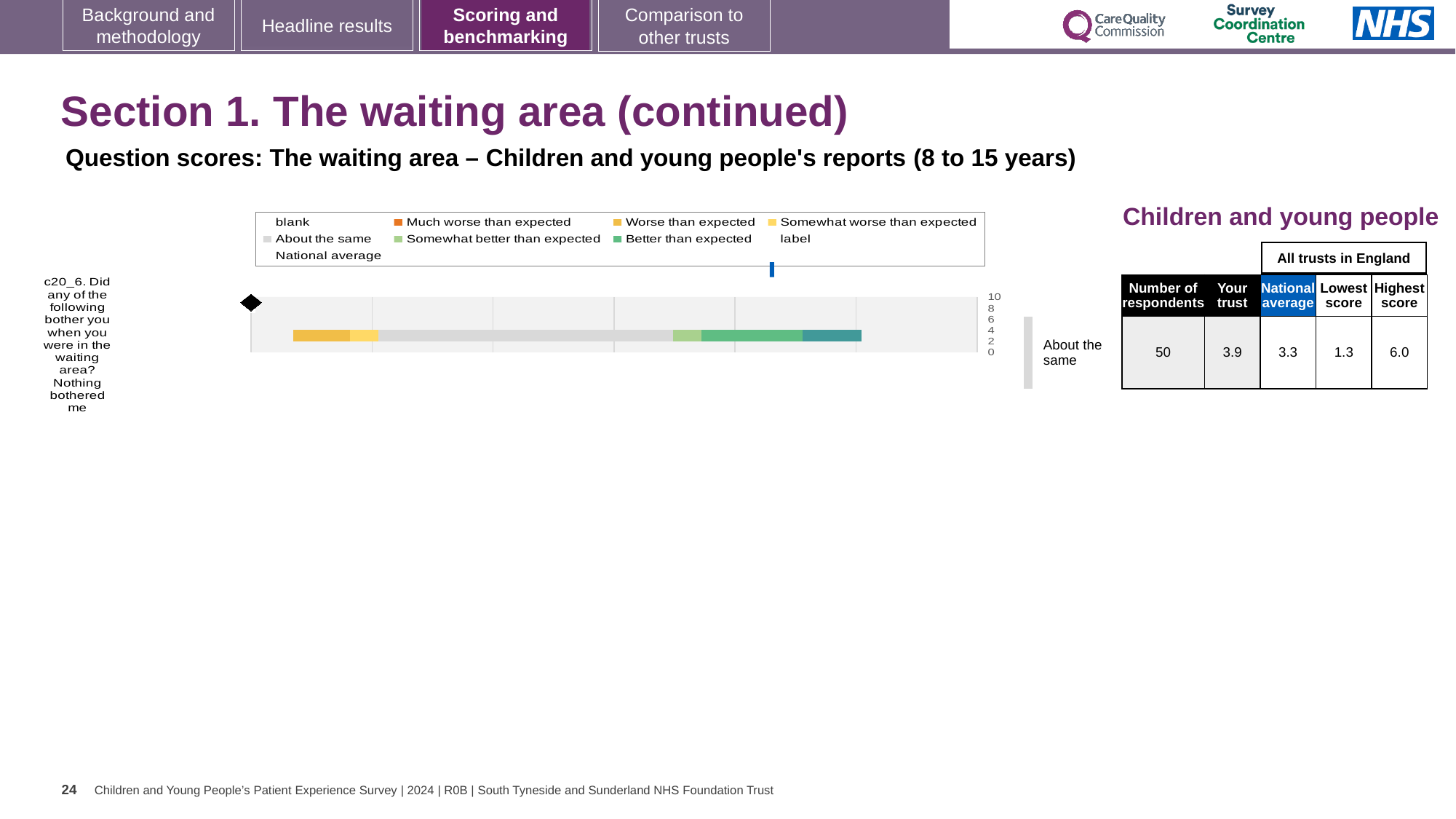
What is the highest score among all trusts in England for question c20_6? 6.0 What kind of chart is shown for question c20_6? Bar chart What is the difference between the 'Your trust' score and the national average for question c20_6? 0.6 What colour is the 'About the same' segment in the chart? Grey Which is higher for question c20_6: the 'Your trust' score or the national average? Your trust How many respondents answered question c20_6? 50 What is the lowest score among all trusts in England for question c20_6? 1.3 What benchmark label is shown to the right of the bar for question c20_6? About the same How many questions (categories) are plotted in the chart? 1 What is the 'Your trust' score for question c20_6? 3.9 How many entries does the chart legend list? 9 What is the national average score for question c20_6? 3.3